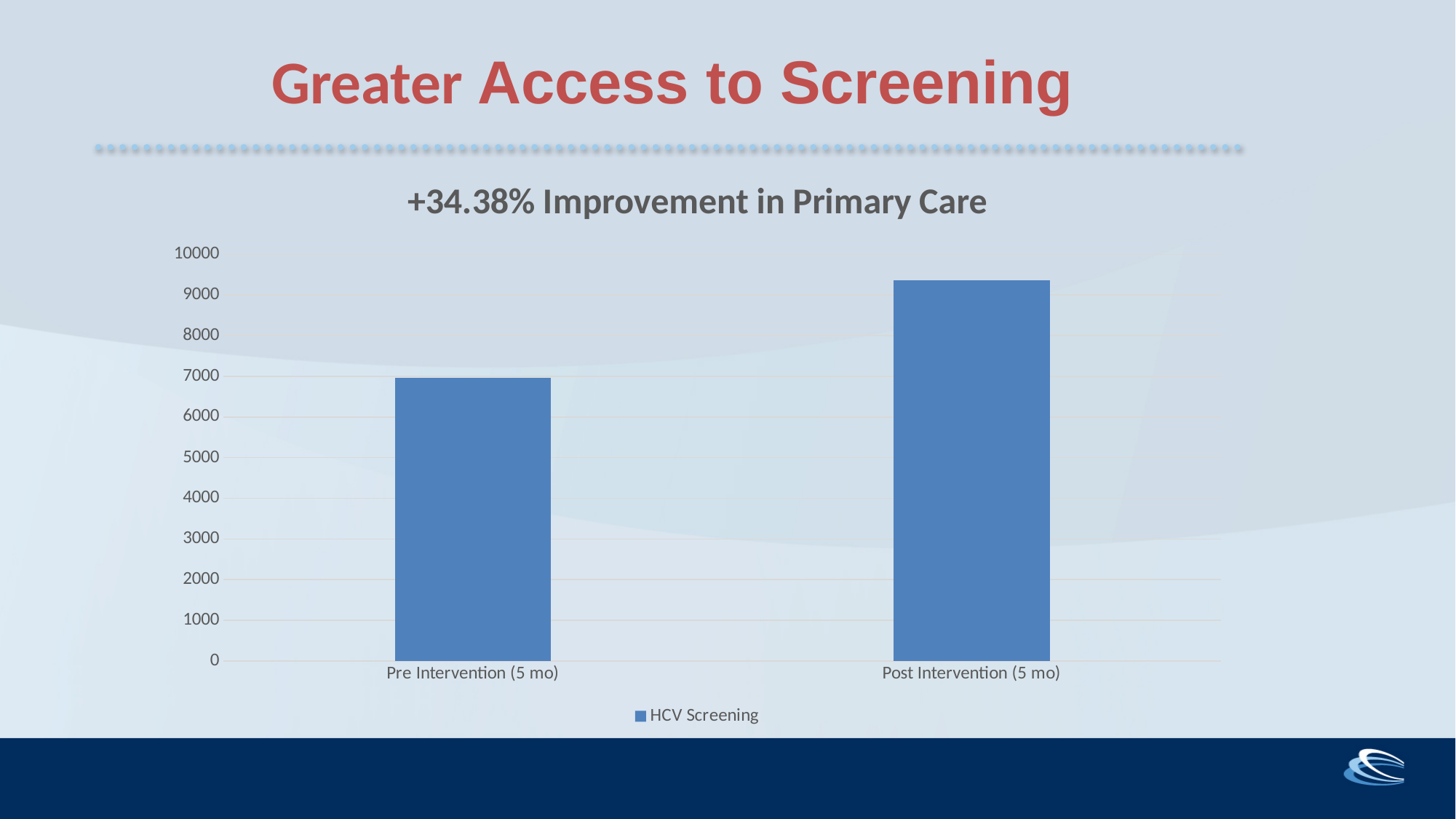
Is the value for Pre Intervention (5 mo) greater or less than 6000? greater What kind of chart is shown on the slide? bar chart How many series does the legend list? 1 Do the values rise or fall from Pre Intervention to Post Intervention? rise What series name appears in the legend? HCV Screening Is the value for Post Intervention (5 mo) greater or less than 9000? greater What is the title of the chart? +34.38% Improvement in Primary Care Which category has the highest HCV Screening value? Post Intervention (5 mo) Which category has the lowest HCV Screening value? Pre Intervention (5 mo) Is the value for Pre Intervention (5 mo) greater or less than 8000? less How many categories are shown on the x axis? 2 Which is larger, the value for Pre Intervention (5 mo) or Post Intervention (5 mo)? Post Intervention (5 mo)